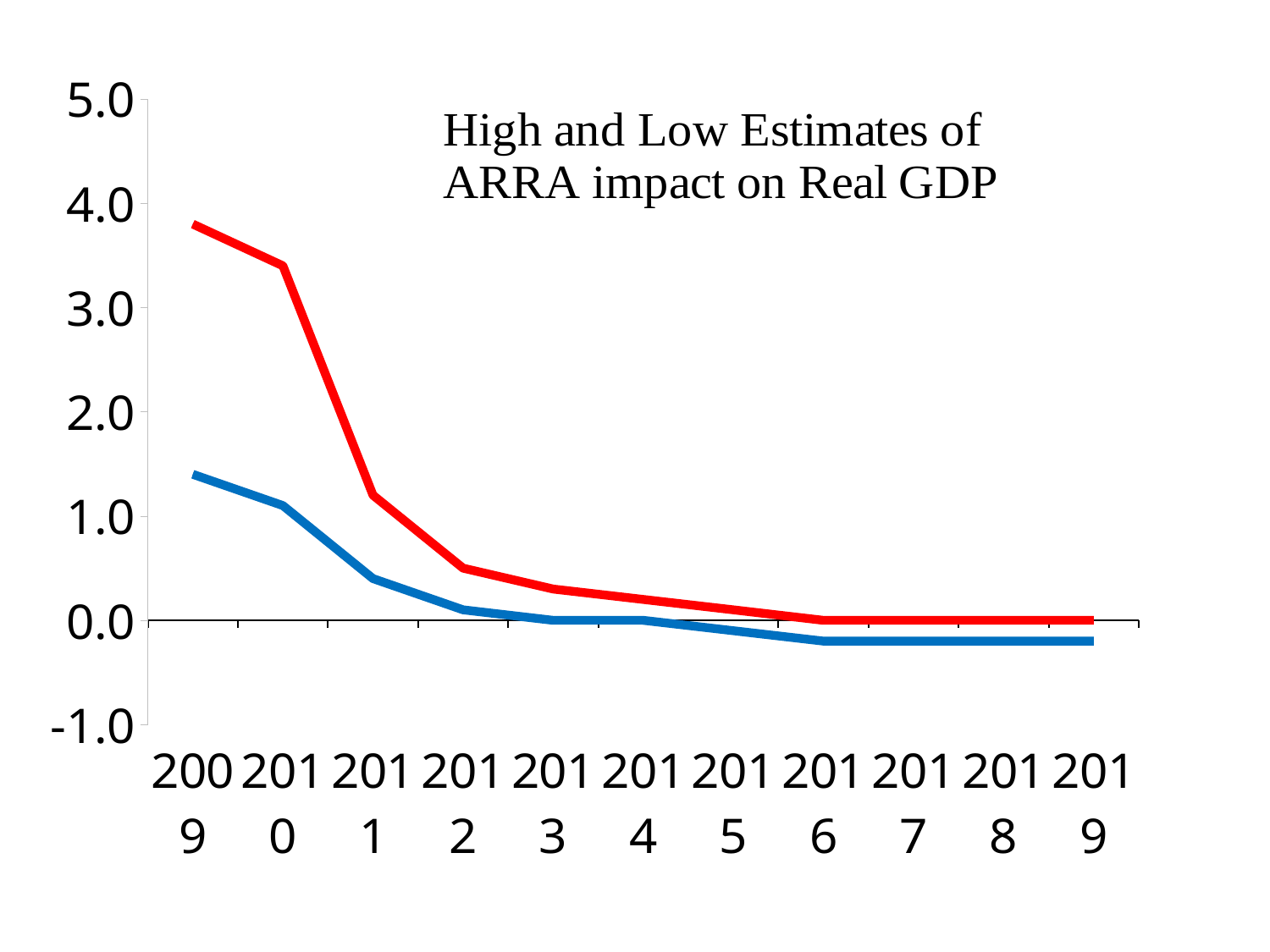
How many lines are plotted on the chart? 2 What is the title of the chart? High and Low Estimates of ARRA impact on Real GDP In which year does the red line reach its highest value? 2009 Do the values of the red line rise or fall from 2009 to 2016? fall What kind of chart is shown on the slide? line chart Is the value of the blue line in 2011 greater or less than 1.0? less Is the value of the red line in 2012 greater or less than 1.0? less In 2010, which line has the larger value, the red line or the blue line? the red line How many years are plotted along the x axis? 11 Is the value of the red line in 2009 greater or less than 3.0? greater